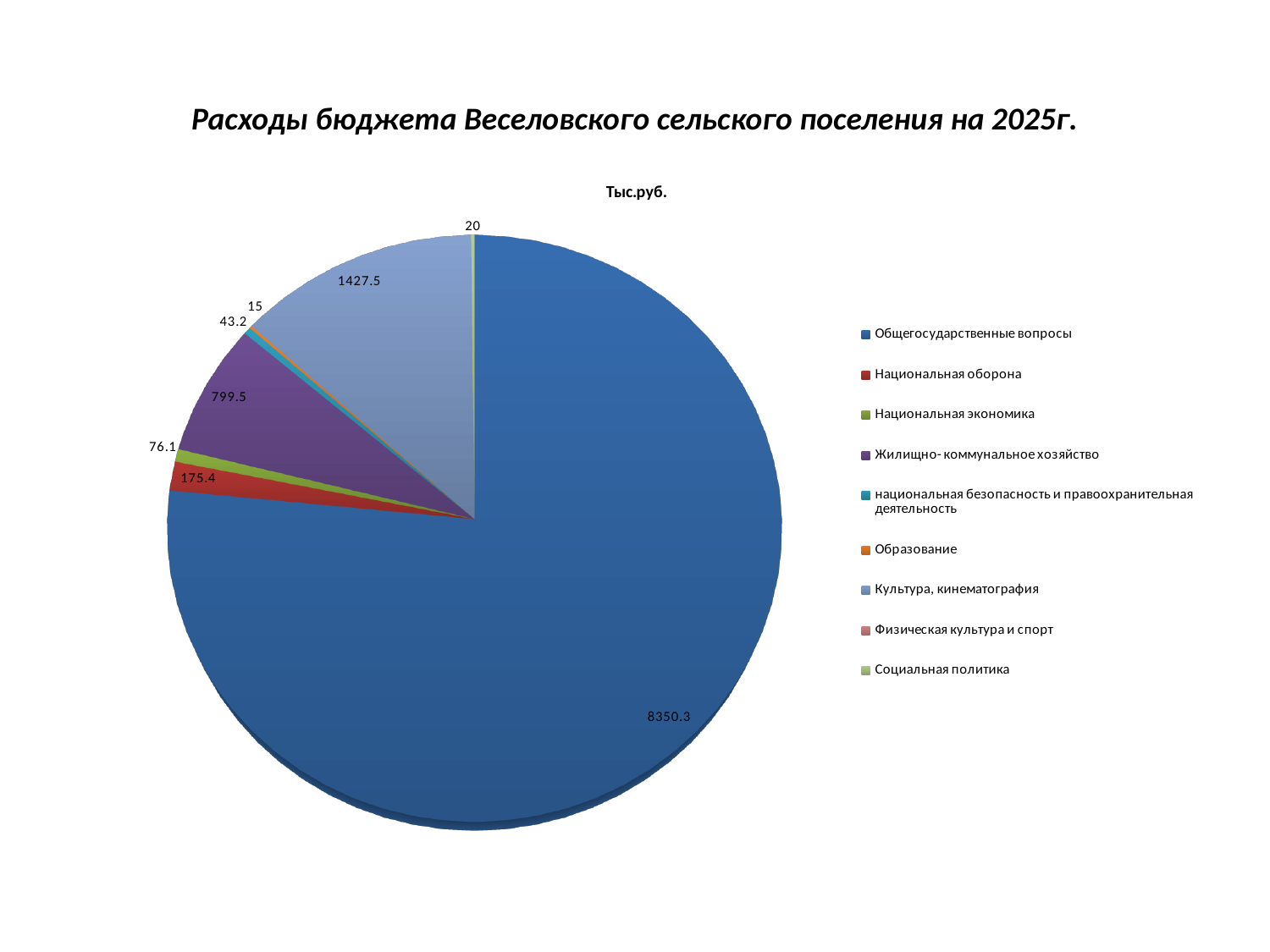
What is the value for Общегосударственные вопросы? 8350.3 What is the value for Культура, кинематография? 1427.5 Which category has the largest slice of the pie? Общегосударственные вопросы What is the value for Образование? 15 What is the difference between Культура, кинематография and Жилищно-коммунальное хозяйство? 628 How many categories does the legend list? 9 What is the value for Национальная экономика? 76.1 Which is larger, Национальная оборона or Национальная экономика? Национальная оборона What is the value for Национальная оборона? 175.4 What type of chart is shown on the slide? pie chart What is the value for Жилищно-коммунальное хозяйство? 799.5 What unit is given in the chart title? Тыс.руб.